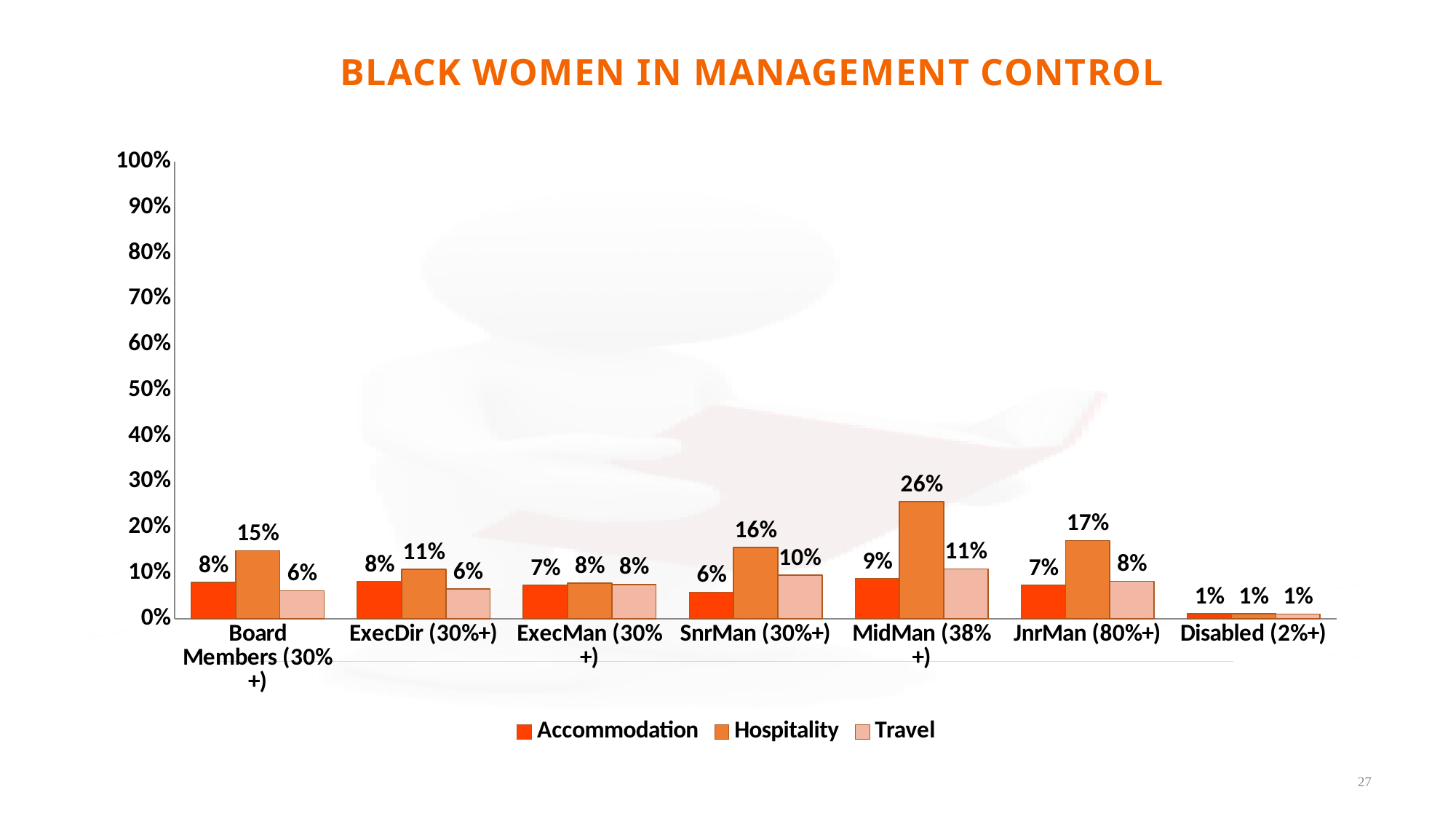
What is the Travel value for JnrMan (80%+)? 8% Which category has the highest Hospitality value? MidMan (38%+) Which is larger for ExecDir (30%+): the Hospitality value or the Travel value? Hospitality How many categories are shown on the x axis? 7 How many series does the legend list? 3 What is the title of the chart? BLACK WOMEN IN MANAGEMENT CONTROL Which category has the lowest Accommodation value? Disabled (2%+) What is the Accommodation value for SnrMan (30%+)? 6% What is the difference between the Hospitality and Accommodation values for Board Members (30%+)? 7% Is the Hospitality value for MidMan (38%+) greater or less than 20%? greater What kind of chart is shown on the slide? Bar chart What is the Hospitality value for MidMan (38%+)? 26%